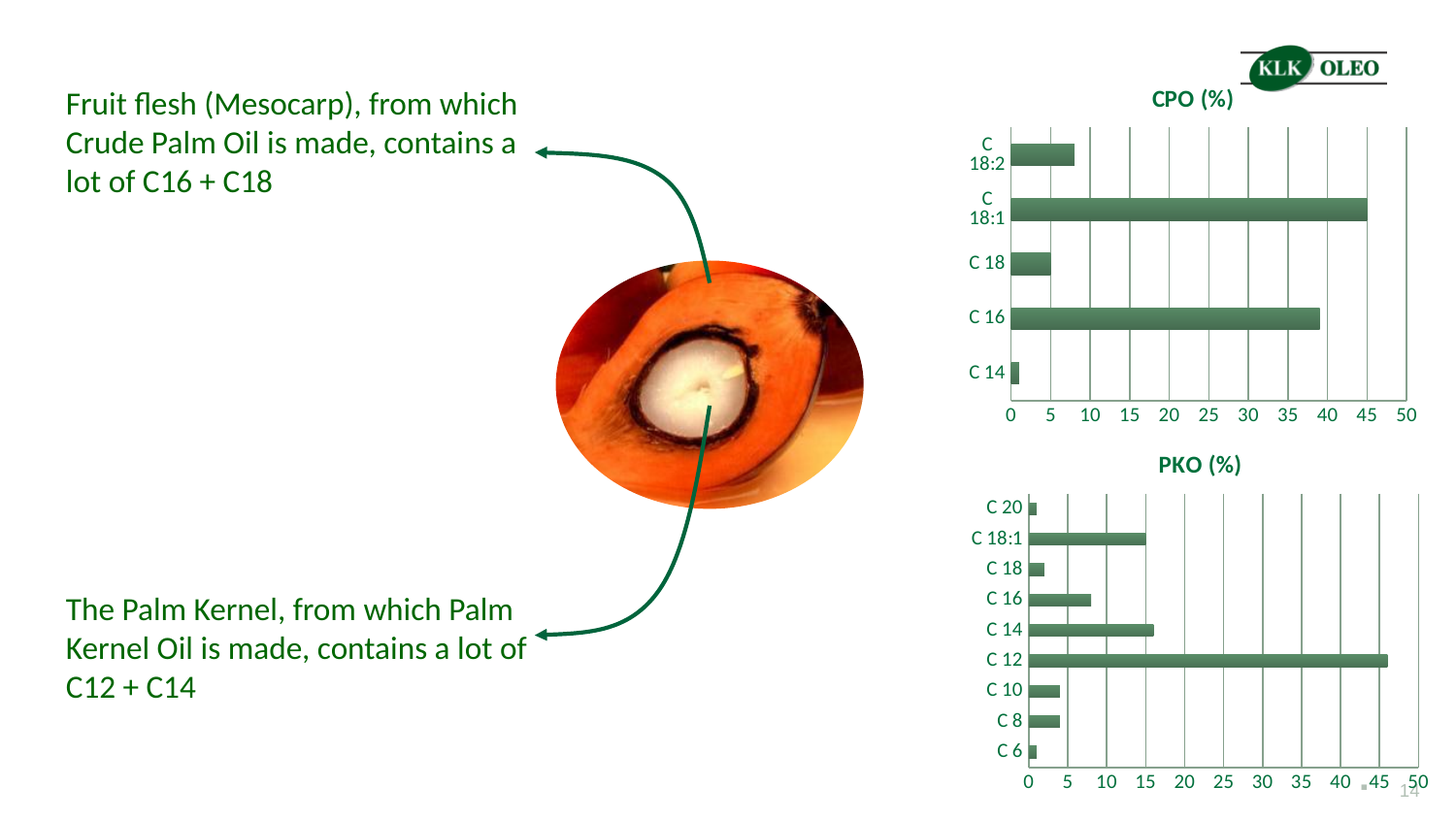
In the PKO (%) chart, is the value for C 12 greater or less than 40? greater In the CPO (%) chart, is the value for C 16 greater or less than 35? greater In the PKO (%) chart, is the value for C 18:1 greater or less than 20? less In the PKO (%) chart, which is larger, C 14 or C 16? C 14 In the CPO (%) chart, which category has the lowest value? C 14 In the CPO (%) chart, which category has the highest value? C 18:1 How many categories are shown in the CPO (%) chart? 5 In the CPO (%) chart, which is larger, C 18:2 or C 18? C 18:2 What kind of chart is the CPO (%) chart? bar chart In the PKO (%) chart, which category has the highest value? C 12 How many categories are shown in the PKO (%) chart? 9